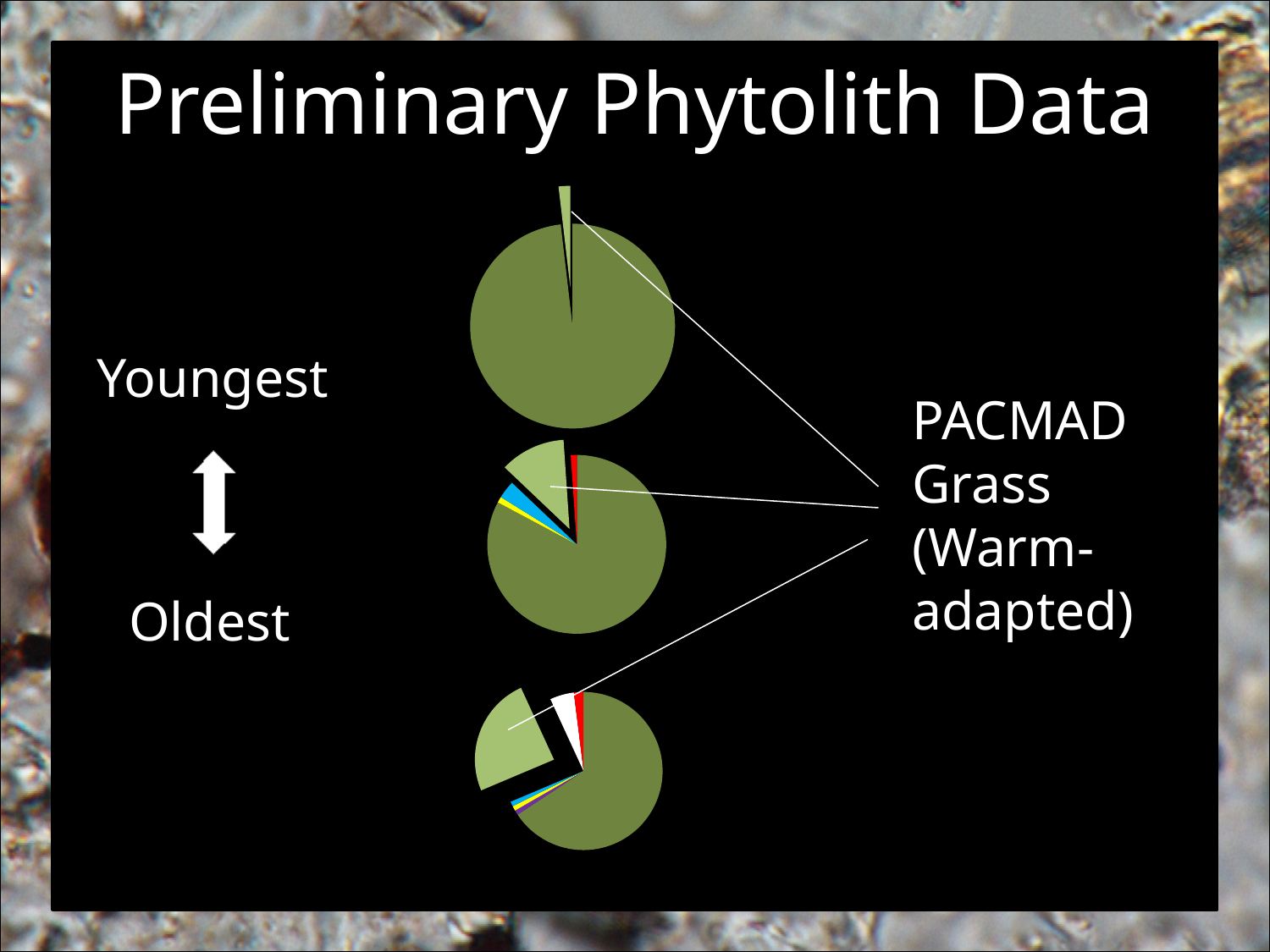
Is the PACMAD Grass (Warm-adapted) slice larger in the top pie chart or the bottom pie chart? Bottom Which pie chart has the smallest PACMAD Grass (Warm-adapted) slice, the top, middle or bottom one? Top Which pie chart represents the youngest sample, the top or the bottom one? Top Which pie chart has the largest PACMAD Grass (Warm-adapted) slice, the top, middle or bottom one? Bottom How many pie charts are on the slide? 3 What kind of charts are shown on the slide? Pie charts What is the title of the slide containing the pie charts? Preliminary Phytolith Data What label do the callout lines from the light green slices point to? PACMAD Grass (Warm-adapted) In the top pie chart, which slice is larger, the dark green one or the light green one? Dark green Going from the youngest sample (top) to the oldest sample (bottom), does the PACMAD Grass (Warm-adapted) share increase or decrease? Increase How many slices does the top pie chart have? 2